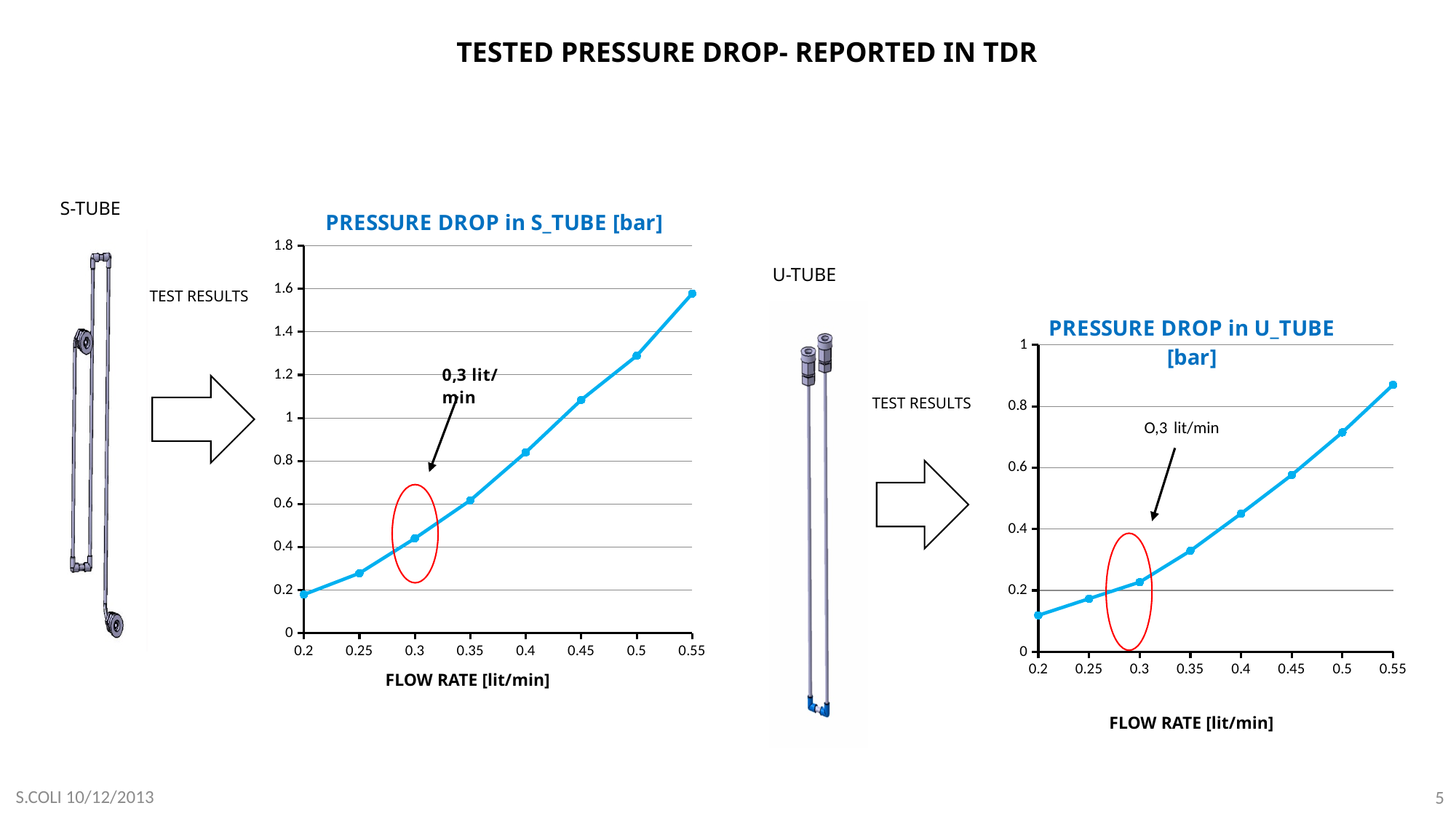
On the "PRESSURE DROP in S_TUBE [bar]" chart, is the value at a flow rate of 0.5 greater or less than 1.2? greater On the "PRESSURE DROP in S_TUBE [bar]" chart, which flow rate has the larger pressure drop, 0.3 or 0.5? 0.5 What is the x-axis title of the "PRESSURE DROP in U_TUBE [bar]" chart? FLOW RATE [lit/min] What kind of chart is the "PRESSURE DROP in S_TUBE [bar]" chart? line chart On the "PRESSURE DROP in S_TUBE [bar]" chart, at which flow rate is the pressure drop lowest? 0.2 On the "PRESSURE DROP in S_TUBE [bar]" chart, which flow rate is circled and annotated with an arrow? 0,3 lit/min On the "PRESSURE DROP in U_TUBE [bar]" chart, is the value at a flow rate of 0.55 greater or less than 0.8? greater On the "PRESSURE DROP in S_TUBE [bar]" chart, do the values rise or fall as the flow rate increases? rise On the "PRESSURE DROP in U_TUBE [bar]" chart, at which flow rate is the pressure drop highest? 0.55 On the "PRESSURE DROP in S_TUBE [bar]" chart, is the value at a flow rate of 0.55 greater or less than 1.4? greater How many data points are plotted on the "PRESSURE DROP in U_TUBE [bar]" chart? 8